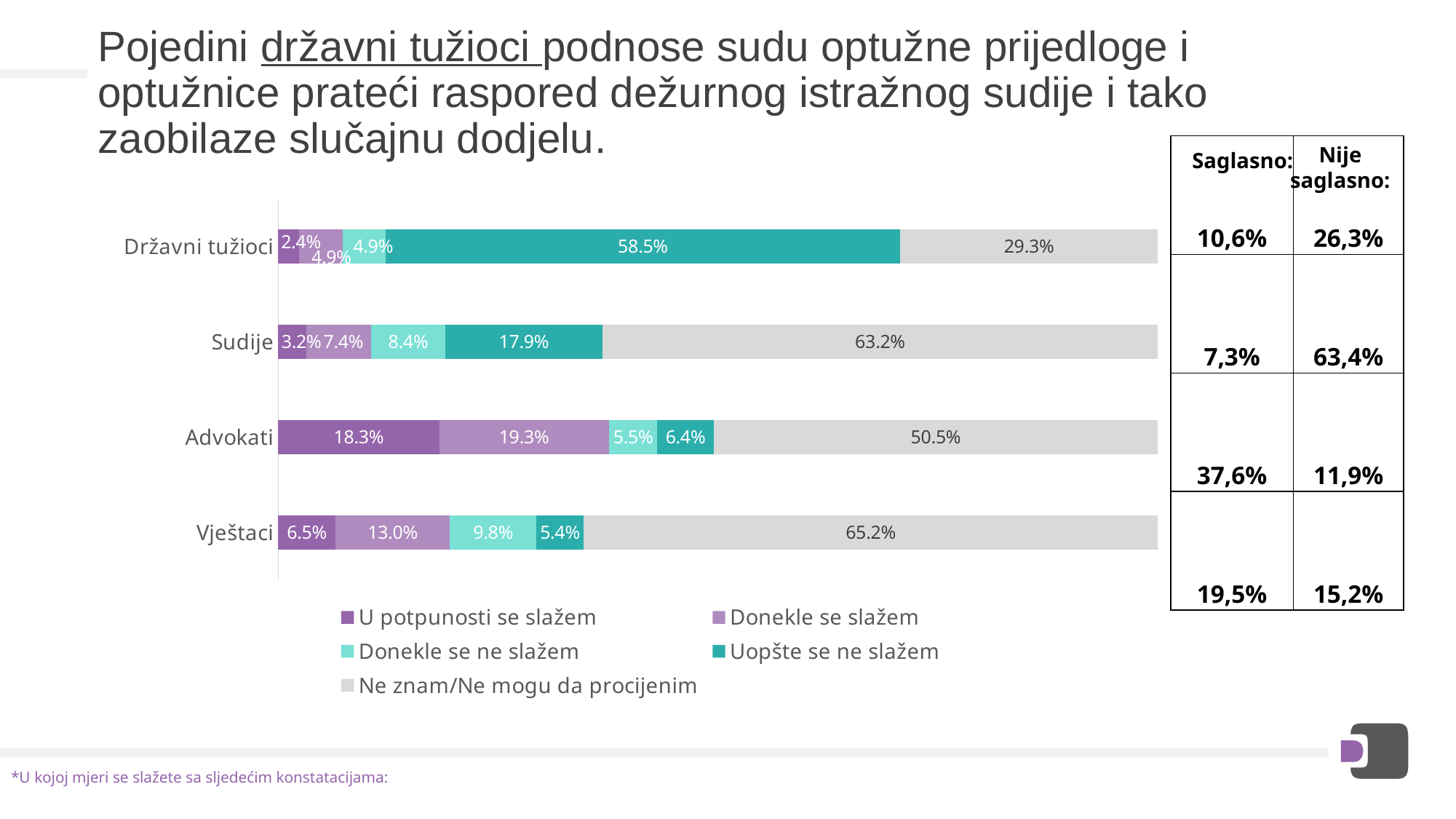
What is the value of 'Donekle se ne slažem' for Vještaci? 9.8% What is the value of 'Uopšte se ne slažem' for Državni tužioci? 58.5% Which is larger: the 'Donekle se slažem' value for Advokati or for Vještaci? Advokati What is the value of 'U potpunosti se slažem' for Advokati? 18.3% What kind of chart is shown on the slide? Stacked bar chart How many series does the chart legend list? 5 What is the value of 'Ne znam/Ne mogu da procijenim' for Sudije? 63.2% Which category has the lowest value for 'Ne znam/Ne mogu da procijenim'? Državni tužioci How many categories are plotted on the chart? 4 Which legend entry is shown in the light grey colour? Ne znam/Ne mogu da procijenim Which category has the highest value for 'U potpunosti se slažem'? Advokati What is the difference between the 'Uopšte se ne slažem' values for Državni tužioci and Sudije? 40.6%